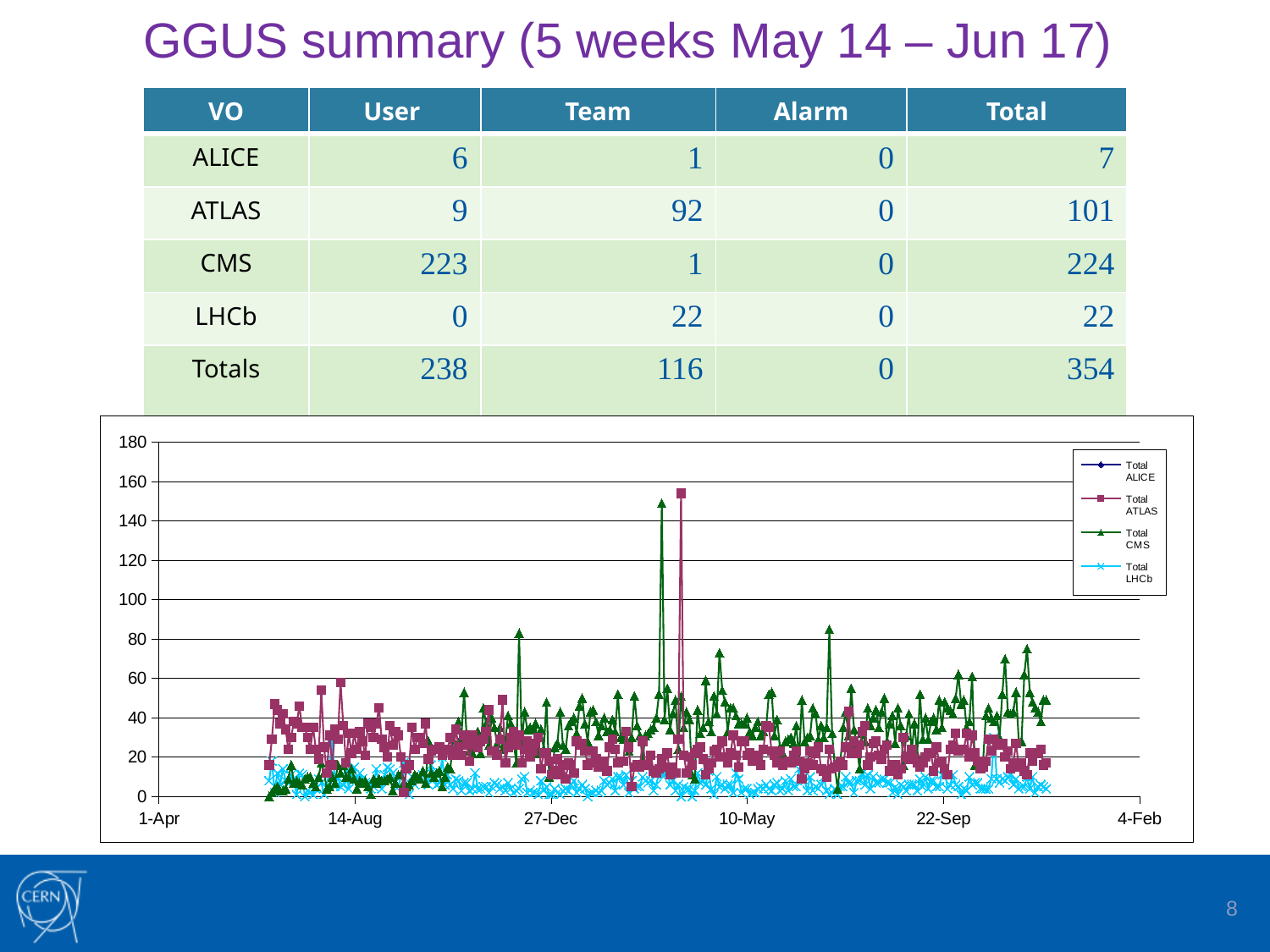
Which series in the chart reaches the highest peak value? Total ATLAS Is the highest peak of the Total CMS series greater or less than 120? greater Is the highest value of the Total LHCb series greater or less than 40? less How many date labels are shown along the chart's horizontal axis? 6 What kind of chart is shown on the slide? line chart Which series is plotted in green with triangle markers? Total CMS How many series does the chart's legend list? 4 Is the highest peak of the Total ATLAS series greater or less than 140? greater What is the first date label on the chart's horizontal axis? 1-Apr What is the highest value shown on the chart's vertical axis? 180